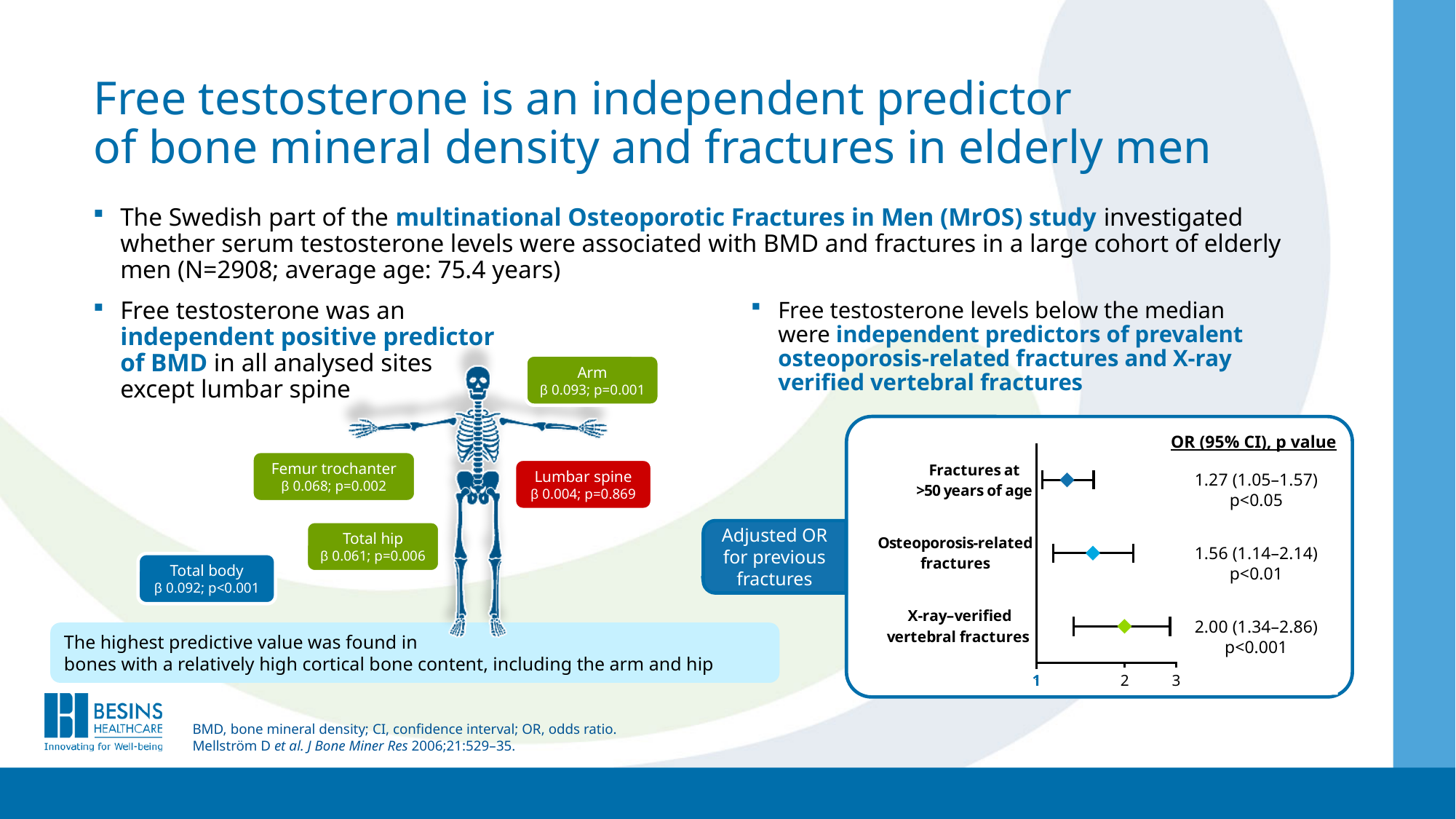
In the forest plot on the right, what is the difference between the odds ratio for X-ray–verified vertebral fractures and the odds ratio for fractures at >50 years of age? 0.73 In the forest plot on the right, what is the adjusted odds ratio for fractures at >50 years of age? 1.27 In the forest plot on the right, what is the 95% confidence interval for X-ray–verified vertebral fractures? 1.34–2.86 In the forest plot on the right, is the odds ratio for X-ray–verified vertebral fractures greater or less than 1? greater How many fracture categories are plotted in the forest plot on the right? 3 In the forest plot on the right, which has the larger adjusted odds ratio: osteoporosis-related fractures or fractures at >50 years of age? Osteoporosis-related fractures In the forest plot on the right, which fracture category has the lowest adjusted odds ratio? Fractures at >50 years of age In the forest plot on the right, what is the adjusted odds ratio for osteoporosis-related fractures? 1.56 In the forest plot on the right, what is the p value shown for osteoporosis-related fractures? p<0.01 In the forest plot on the right, which fracture category has the highest adjusted odds ratio? X-ray–verified vertebral fractures In the forest plot on the right, what is the adjusted odds ratio for X-ray–verified vertebral fractures? 2.00 What kind of chart is shown on the right of the slide? Forest plot (point estimates with confidence interval error bars)